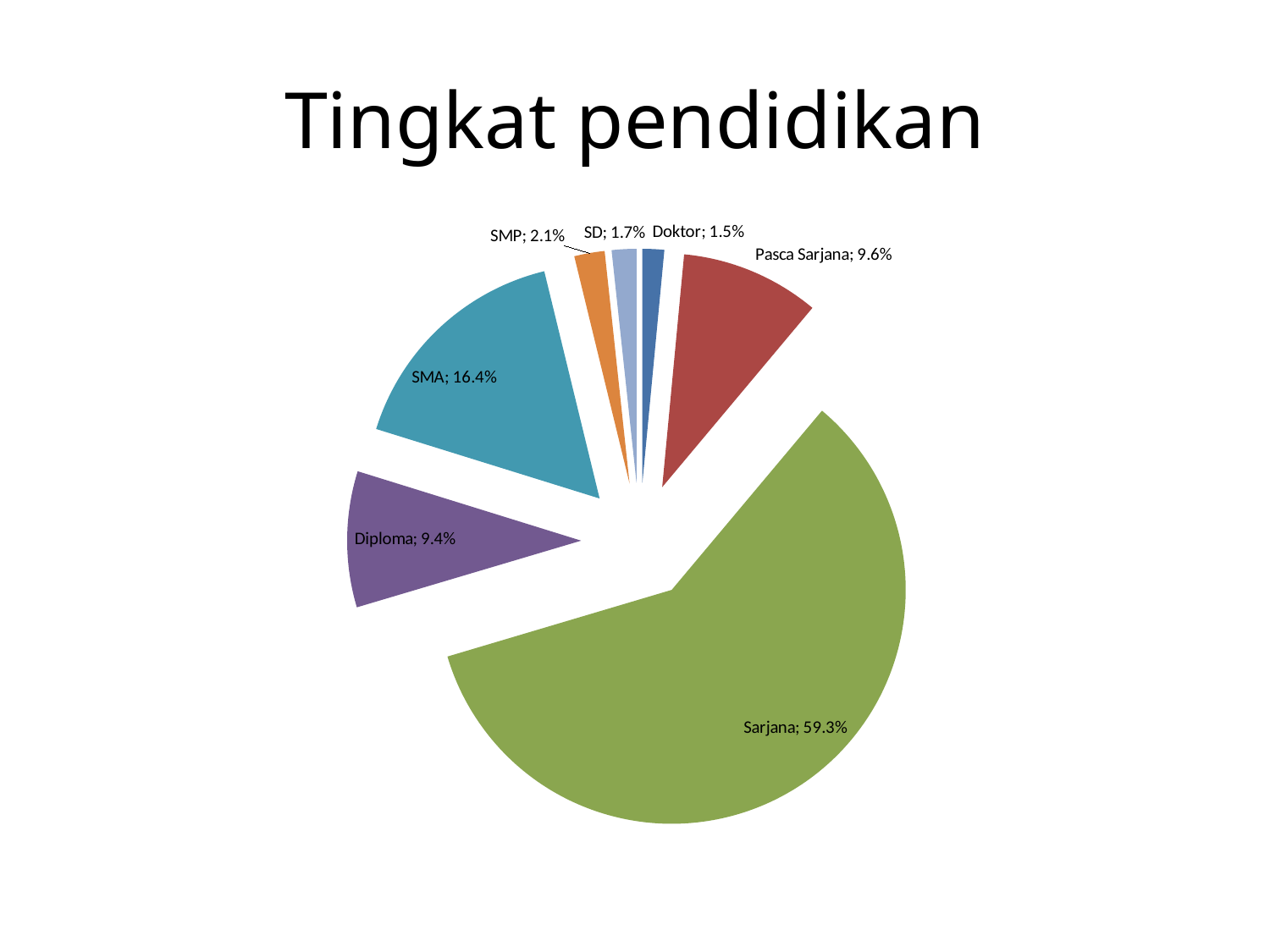
What is the share for Pasca Sarjana? 9.6% What is the share for Doktor? 1.5% Which category has the largest slice? Sarjana How many categories are shown in the pie chart? 7 What is the share for Sarjana? 59.3% What type of chart is shown on the slide? Pie chart What is the share for SMA? 16.4% What is the title of the chart? Tingkat pendidikan Which is larger, the share for Pasca Sarjana or the share for Diploma? Pasca Sarjana What is the difference between the shares of SMP and SD? 0.4% What is the difference between the shares of SMA and Diploma? 7.0% Which category has the smallest slice? Doktor